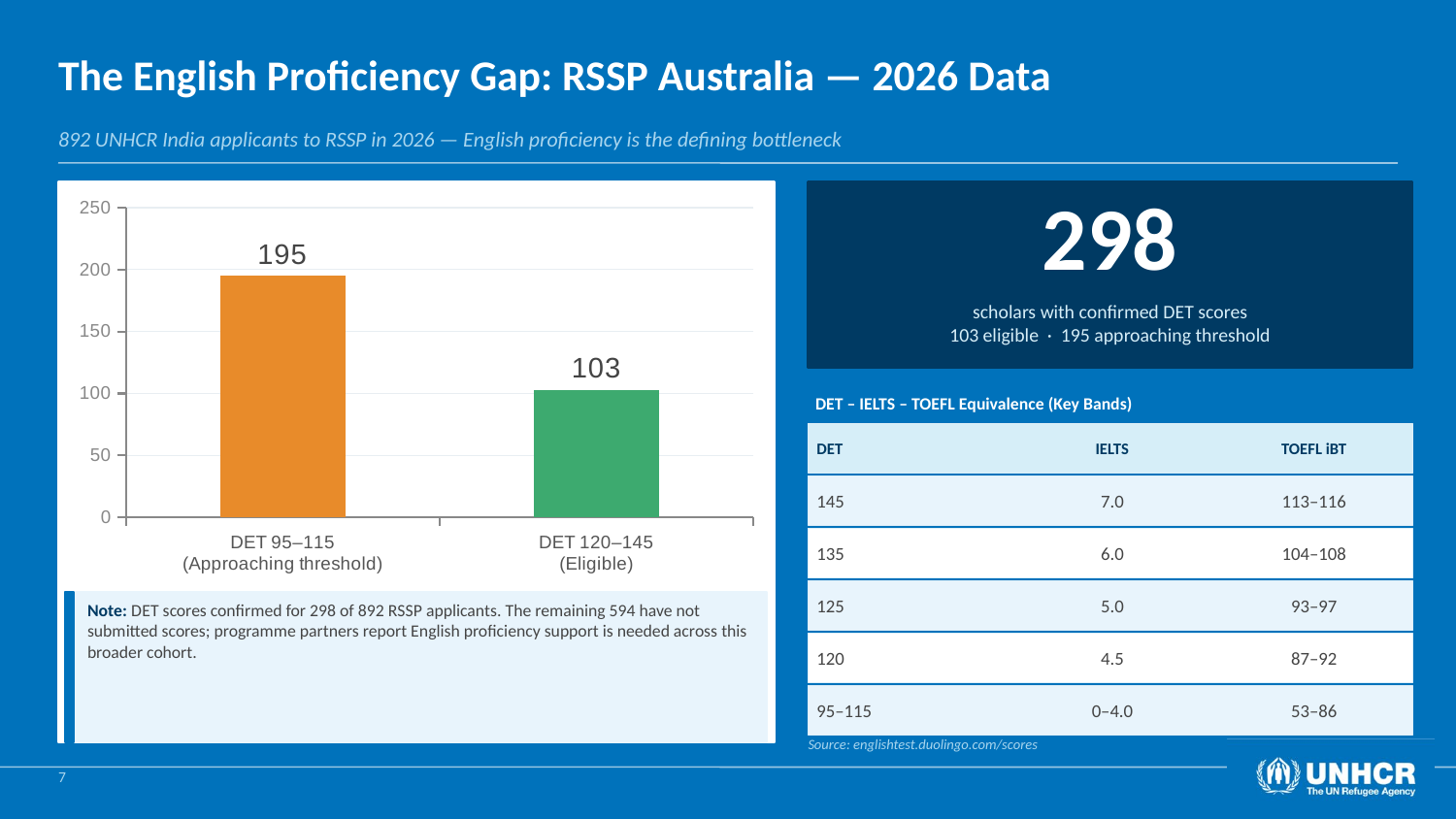
Which category has the lowest value? DET 120–145 (Eligible) What colour is the bar for DET 120–145 (Eligible)? green How many categories are shown in the chart? 2 Which is larger, the value for DET 95–115 or DET 120–145? DET 95–115 What kind of chart is shown on the slide? bar chart What is the difference between the values for DET 95–115 and DET 120–145? 92 Is the value for DET 120–145 (Eligible) greater or less than 150? less What is the value for DET 95–115 (Approaching threshold)? 195 Is the value for DET 95–115 (Approaching threshold) greater or less than 150? greater Which category has the highest value? DET 95–115 (Approaching threshold) What is the value for DET 120–145 (Eligible)? 103 What is the total of the two bars in the chart? 298